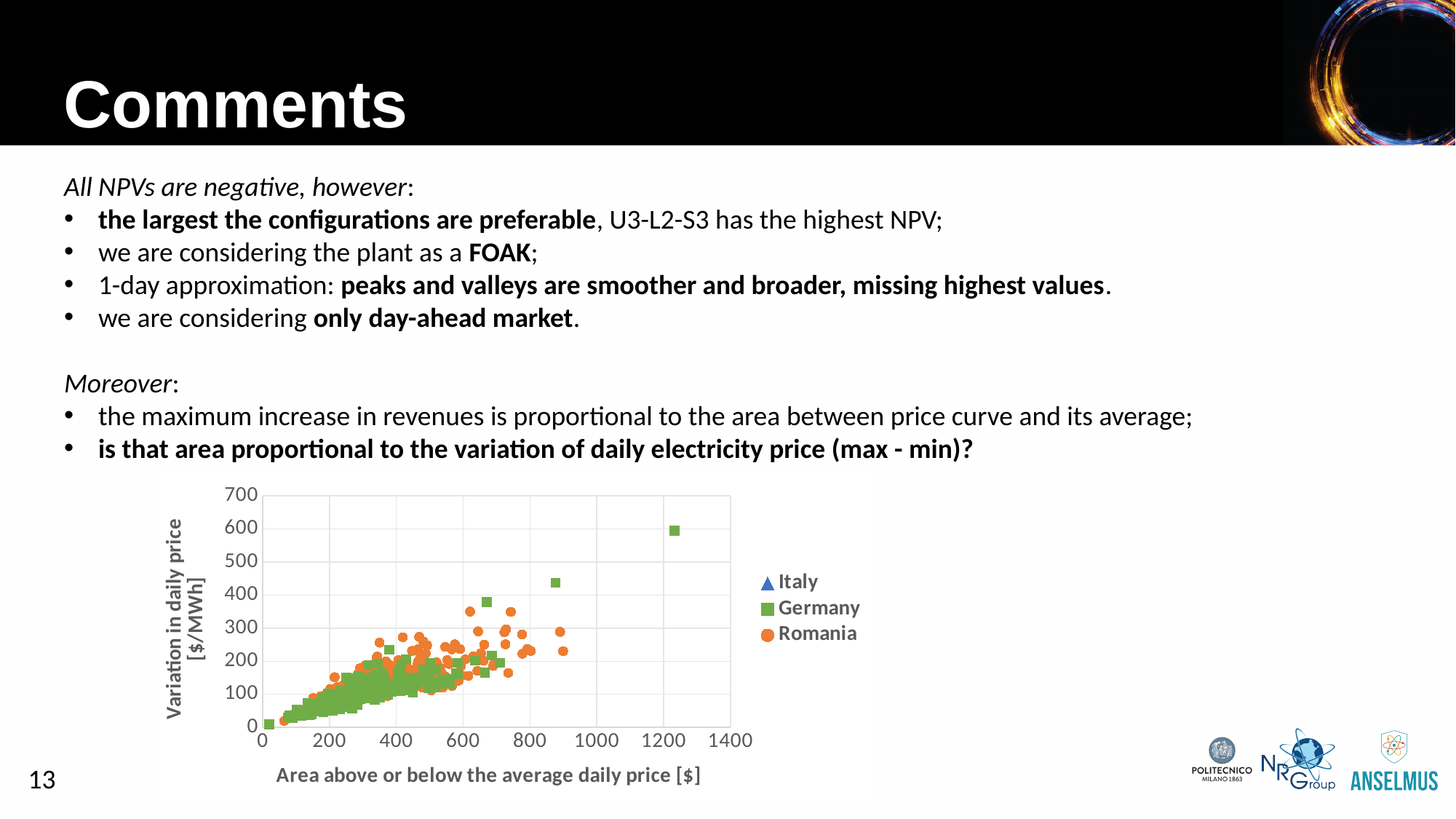
As the area above or below the average daily price increases, does the variation in daily price generally rise or fall? rise What is the highest value shown on the y axis of the chart? 700 Is the area value for the rightmost Germany point greater or less than 1000? greater Which series is plotted with orange circle markers? Romania What kind of chart is shown on the slide? scatter chart How many series does the chart legend list? 3 Which countries are listed in the chart legend? Italy, Germany, Romania What is the highest value shown on the x axis of the chart? 1400 Is the variation in daily price for the rightmost Germany point greater or less than 500? greater What is the title of the x axis of the chart? Area above or below the average daily price [$] Which series contains the point with the highest variation in daily price? Germany